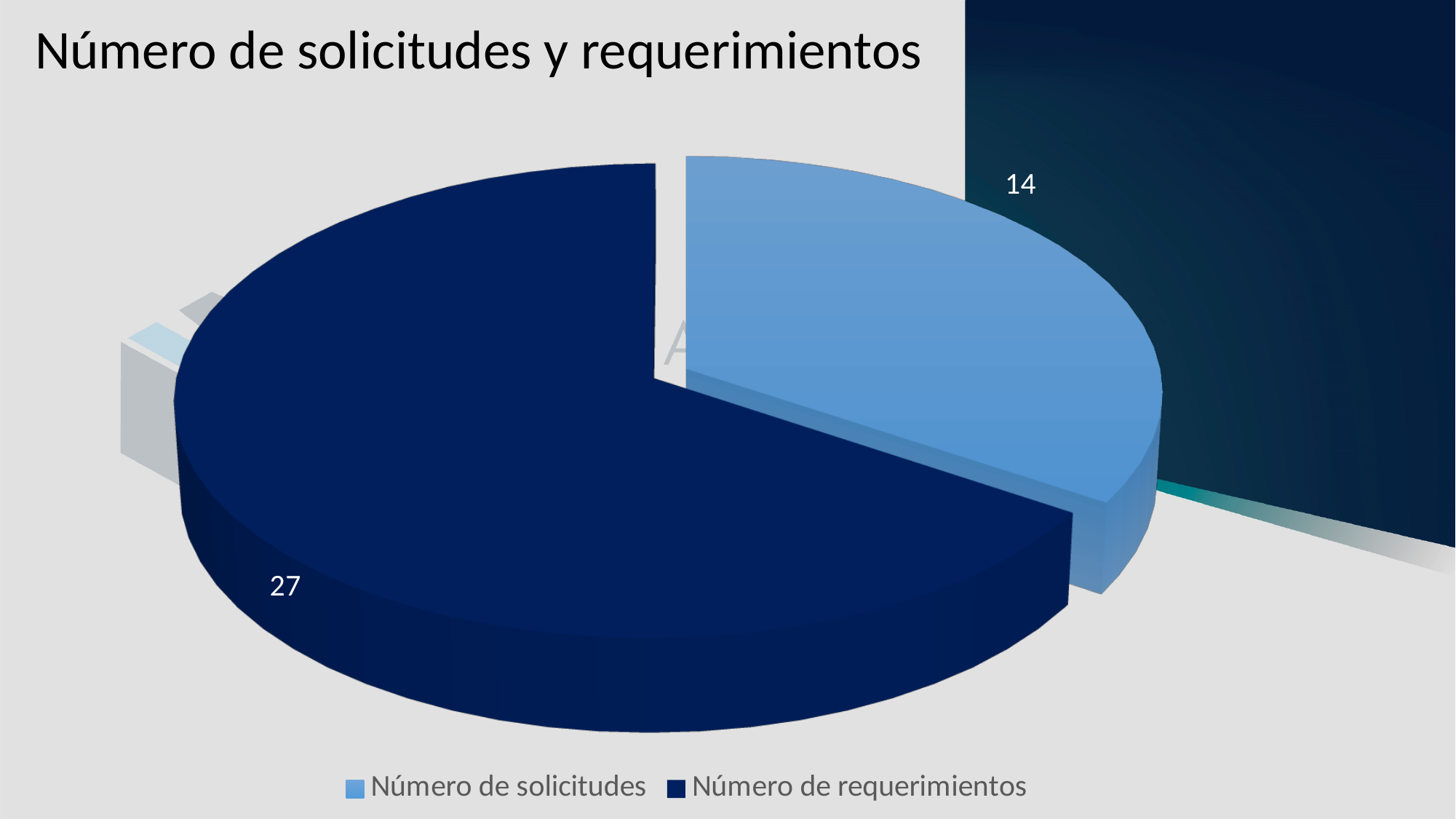
How many entries does the legend list? 2 What kind of chart is shown on the slide? Pie chart What is the value for Número de requerimientos? 27 Which slice is the largest? Número de requerimientos What is the difference between Número de requerimientos and Número de solicitudes? 13 What is the title of the chart? Número de solicitudes y requerimientos What is the total of the two slices? 41 Which slice is the smallest? Número de solicitudes How many slices does the pie chart have? 2 What is the value for Número de solicitudes? 14 Which legend entry is shown in dark blue? Número de requerimientos Which is larger, Número de solicitudes or Número de requerimientos? Número de requerimientos